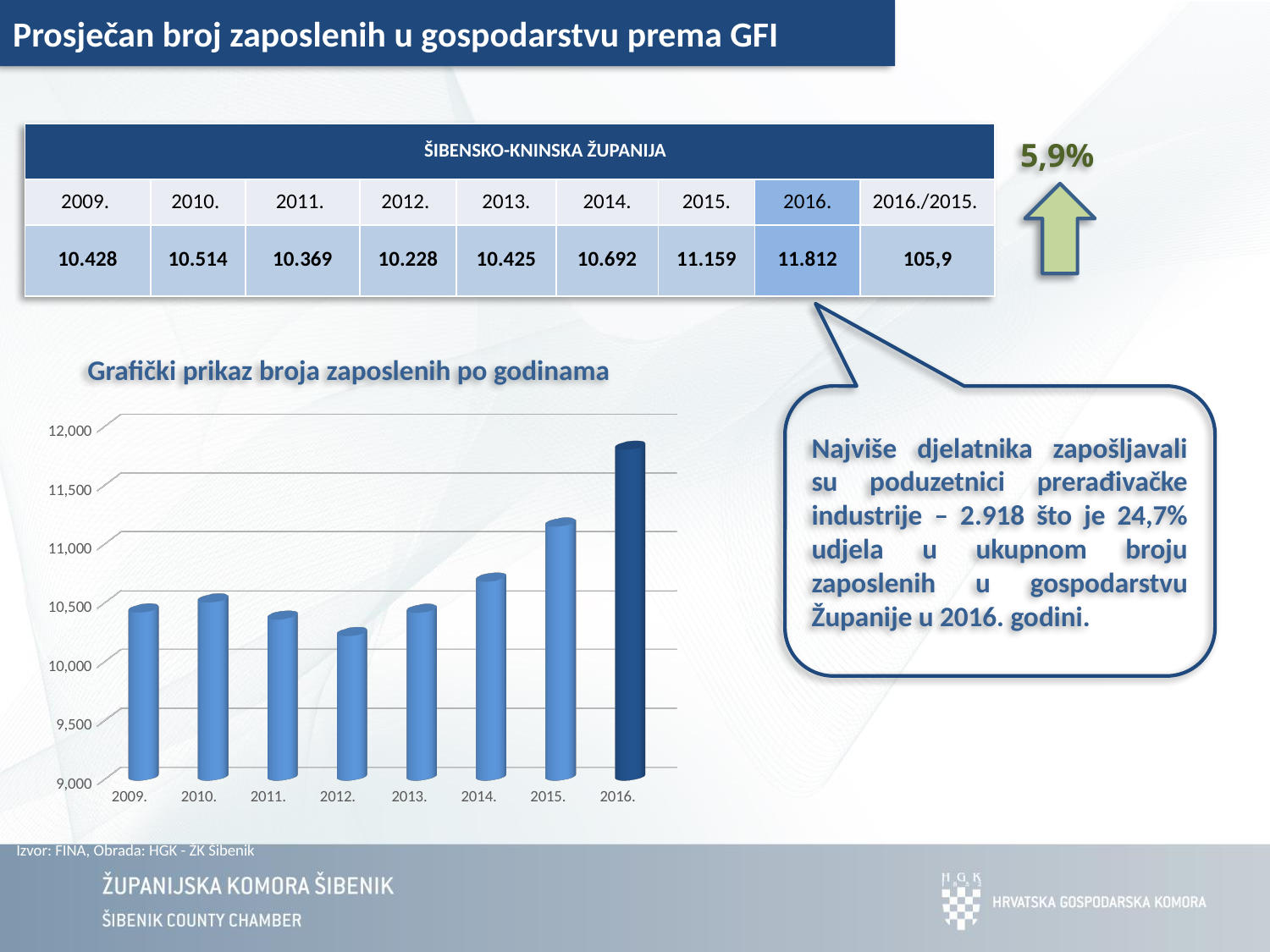
Which is larger, the value for 2014. or the value for 2015.? 2015. Is the value for 2016. greater or less than 11,500? greater What kind of chart is shown on the slide? bar chart Using the values in the table, what is the difference between the 2016. and 2015. values? 653 How many years are plotted in the chart? 8 Is the value for 2015. greater or less than 11,000? greater Which year has the highest bar in the chart? 2016. What is the title of the chart? Grafički prikaz broja zaposlenih po godinama According to the table on the slide, what is the average number of employees in 2016.? 11.812 Is the value for 2012. greater or less than 10,500? less Do the values rise or fall from 2012. to 2016.? rise Which year has the lowest bar in the chart? 2012.